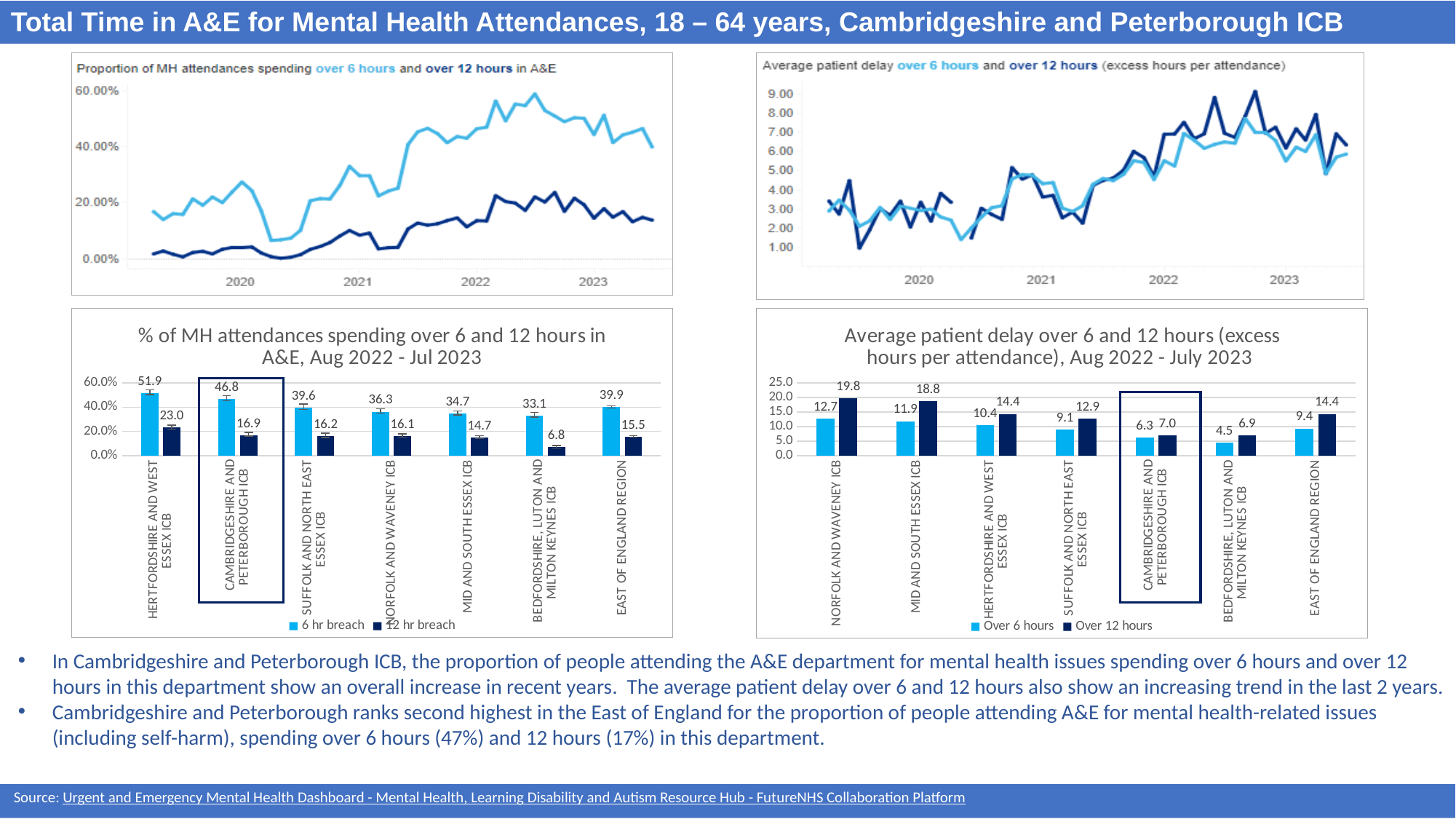
In the bottom-right chart 'Average patient delay over 6 and 12 hours', is the Over 12 hours value larger for Mid and South Essex ICB or for Cambridgeshire and Peterborough ICB? Mid and South Essex ICB In the bottom-left chart '% of MH attendances spending over 6 and 12 hours in A&E', how many series does the legend list? 2 In the bottom-left chart '% of MH attendances spending over 6 and 12 hours in A&E', what is the 6 hr breach value for Cambridgeshire and Peterborough ICB? 46.8 In the bottom-right chart 'Average patient delay over 6 and 12 hours', what is the Over 12 hours value for Norfolk and Waveney ICB? 19.8 In the bottom-right chart 'Average patient delay over 6 and 12 hours', how many categories are shown on the x axis? 7 What kind of chart is the top-left chart 'Proportion of MH attendances spending over 6 hours and over 12 hours in A&E'? Line chart In the bottom-right chart 'Average patient delay over 6 and 12 hours', which category has the lowest Over 6 hours value? Bedfordshire, Luton and Milton Keynes ICB In the top-right chart 'Average patient delay over 6 hours and over 12 hours', do the values generally rise or fall from 2020 to 2023? Rise In the bottom-right chart 'Average patient delay over 6 and 12 hours', what is the difference between the Over 12 hours and Over 6 hours values for East of England Region? 5.0 In the bottom-left chart '% of MH attendances spending over 6 and 12 hours in A&E', what is the difference between the 6 hr breach values for Hertfordshire and West Essex ICB and Cambridgeshire and Peterborough ICB? 5.1 In the bottom-left chart '% of MH attendances spending over 6 and 12 hours in A&E', which category has the lowest 12 hr breach value? Bedfordshire, Luton and Milton Keynes ICB In the bottom-left chart '% of MH attendances spending over 6 and 12 hours in A&E', which ICB has the highest 6 hr breach value? Hertfordshire and West Essex ICB